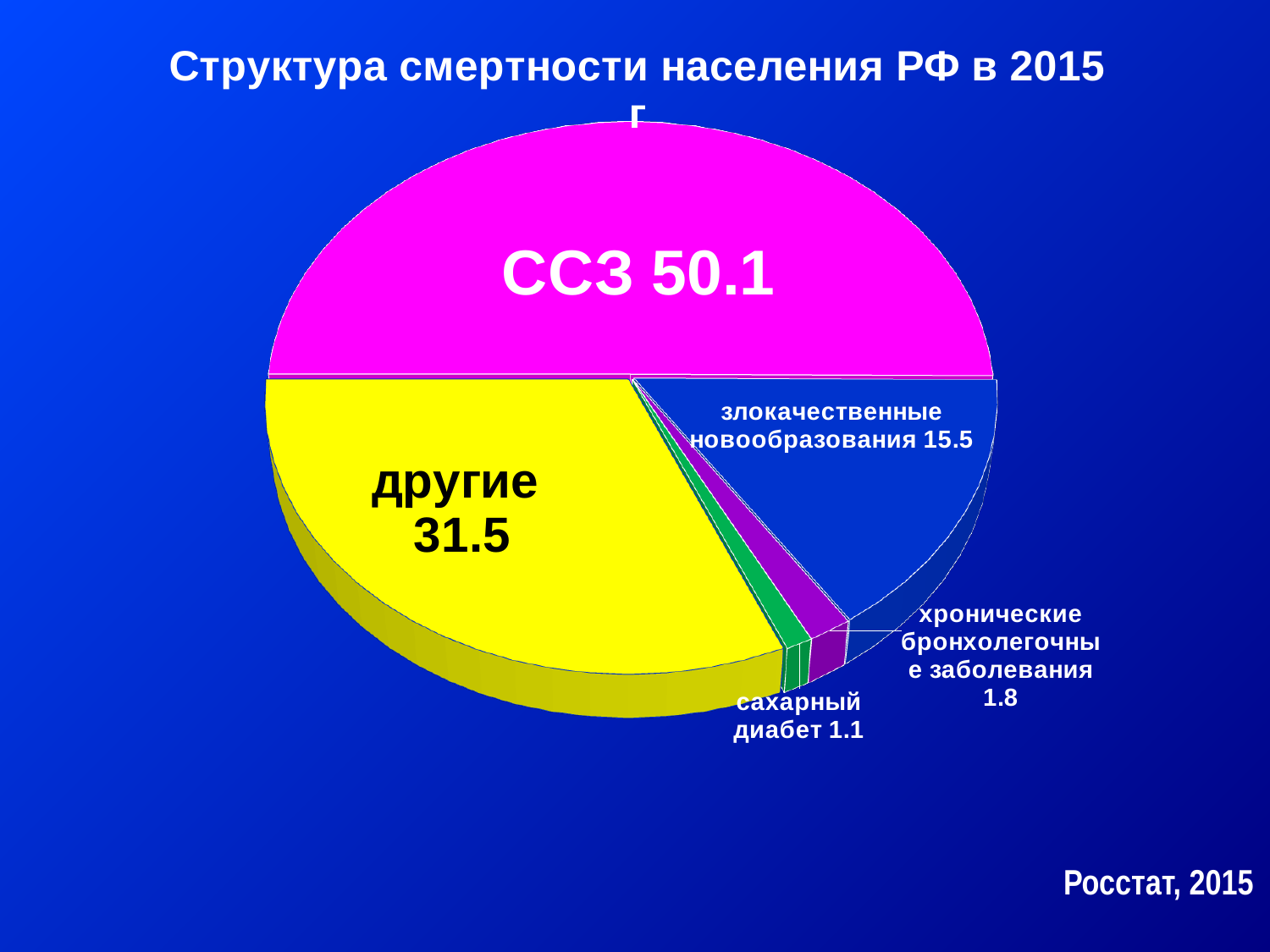
What is the title of the chart? Структура смертности населения РФ в 2015 г Which category has the largest slice of the pie? ССЗ What is the value shown for другие? 31.5 What is the difference between the values for ССЗ and другие? 18.6 What kind of chart is shown on the slide? pie chart Which is larger, the value for злокачественные новообразования or the value for другие? другие What is the value shown for злокачественные новообразования? 15.5 What is the value shown for сахарный диабет? 1.1 How many labeled slices does the pie chart have? 5 What is the value shown for хронические бронхолегочные заболевания? 1.8 What is the value shown for ССЗ? 50.1 Which category has the smallest slice of the pie? сахарный диабет